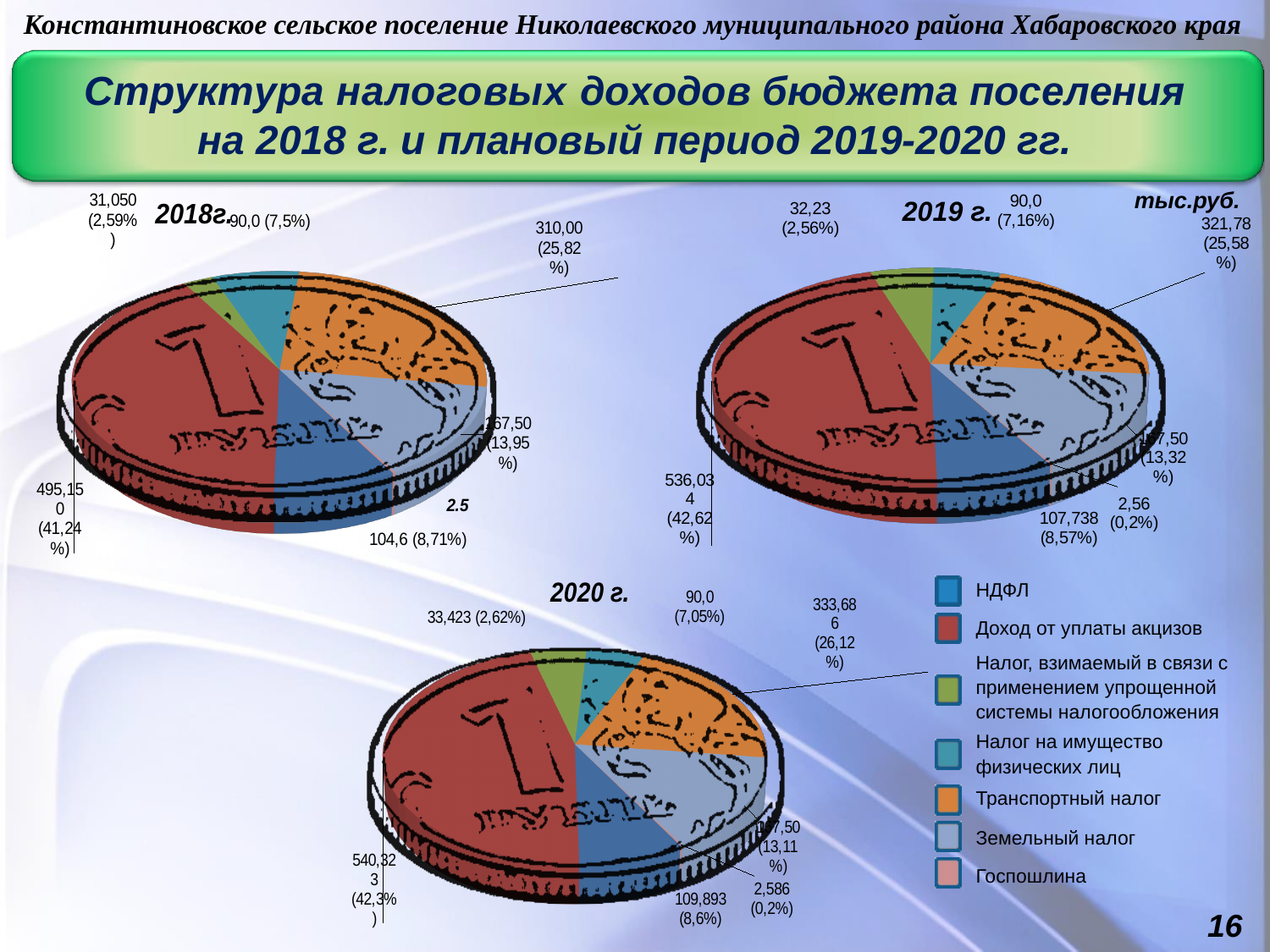
How many pie charts are on the slide? 3 What kind of charts are shown on the slide? Pie charts In the 2020 г. pie chart, what is the value of the smallest slice? 2,586 (0,2%) What is the difference between the largest slice in the 2020 г. chart (540,323) and the largest slice in the 2019 г. chart (536,034)? 4,289 How many categories does the legend list? 7 In the 2018 г. pie chart, what is the value of the largest slice? 495,150 (41,24%) In the 2018 г. pie chart, what is the value of the slice labelled 25,82%? 310,00 In the 2019 г. pie chart, what is the value of the smallest slice? 2,56 (0,2%) In the 2019 г. pie chart, what is the value of the largest slice? 536,034 (42,62%) In what units are the values on the slide given? тыс.руб. In the 2020 г. pie chart, what share does the largest slice have? 42,3% Which is larger: the largest slice in the 2019 г. chart or the largest slice in the 2020 г. chart? 2020 г. (540,323)